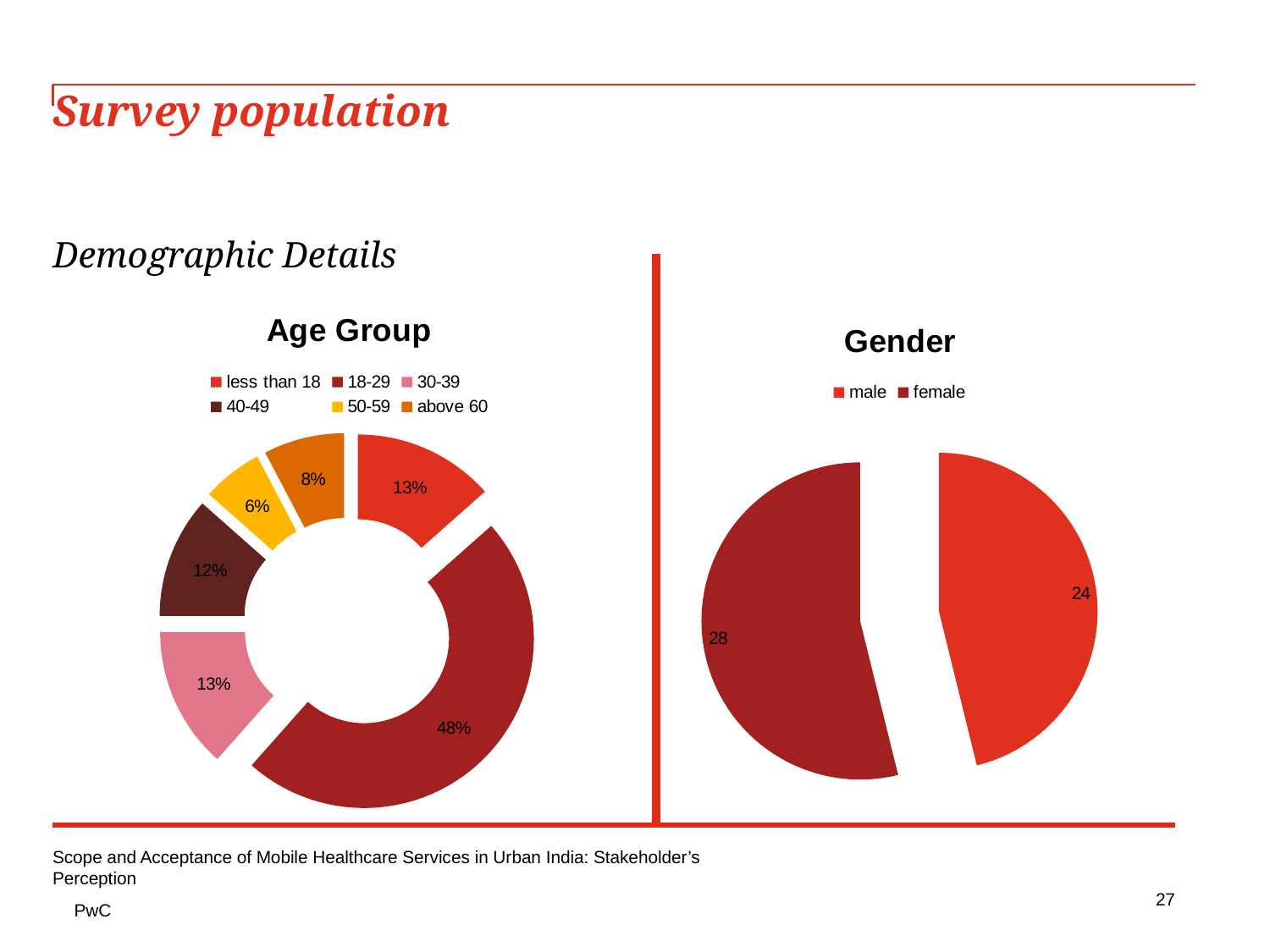
In the Age Group chart, what percentage of the survey population is in the 18-29 age group? 48% How many age groups are shown in the Age Group chart? 6 In the Age Group chart, which age group has the smallest share? 50-59 In the Age Group chart, what is the difference between the 18-29 share and the 40-49 share? 36% In the Gender chart, what is the difference between the number of female and male respondents? 4 In the Age Group chart, what percentage is shown for the above 60 age group? 8% In the Gender chart, how many respondents are female? 28 In the Age Group chart, which age group has the largest share? 18-29 What type of chart is the Gender chart? Pie chart In the Gender chart, how many respondents are male? 24 In the Age Group chart, which is larger: the share for 40-49 or the share for above 60? 40-49 In the Age Group chart, what percentage is shown for the 50-59 age group? 6%